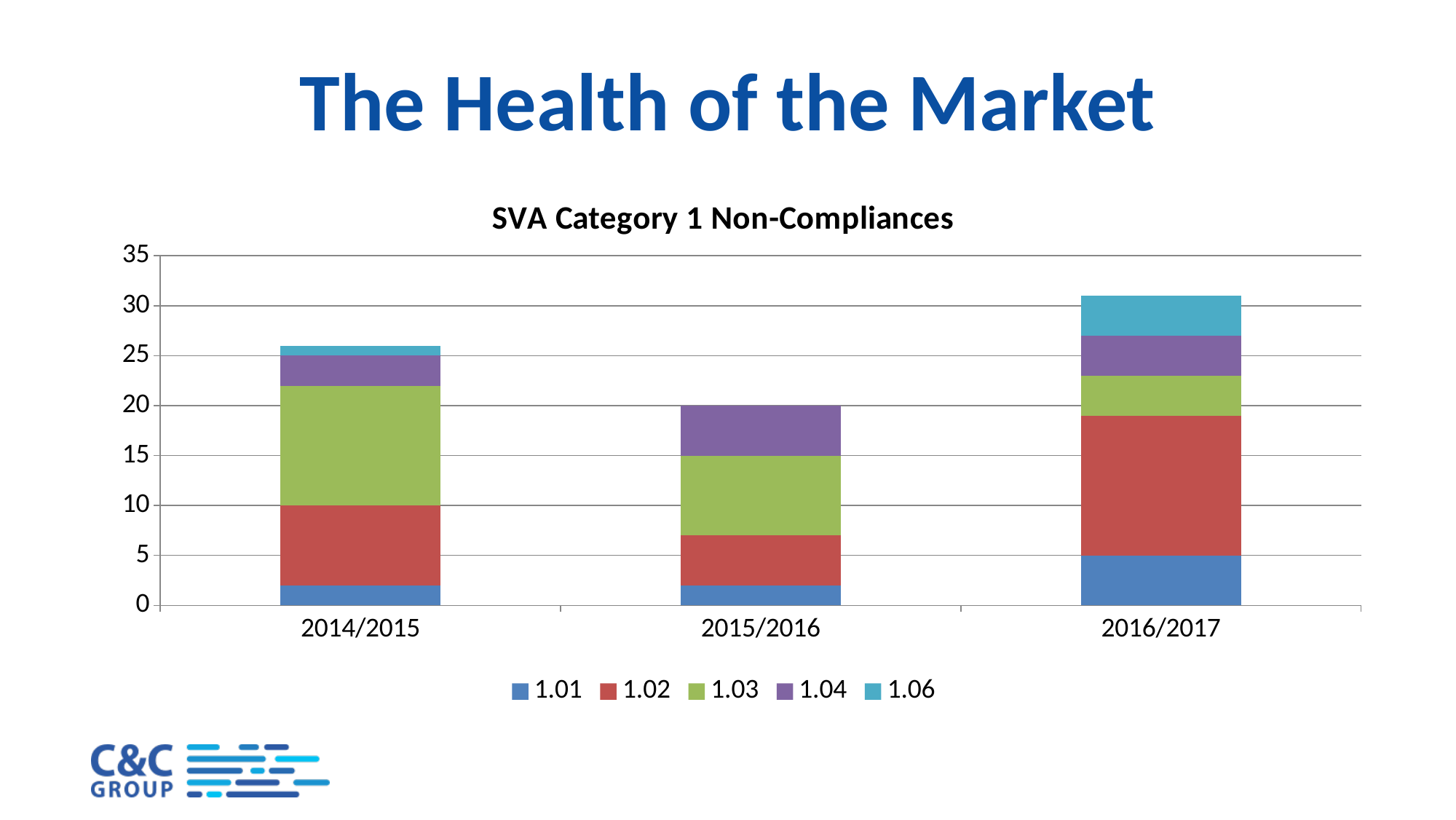
What is the total height of the stacked bar for 2015/2016? 20 Is the total for 2014/2015 greater or less than 30? less How many year categories are shown on the x axis of the chart? 3 What kind of chart is shown on the slide? Stacked bar chart Is the value for series 1.02 in 2016/2017 greater or less than 10? greater Is the total for 2016/2017 greater or less than 25? greater Which is larger, the total for 2014/2015 or the total for 2015/2016? 2014/2015 Which year has the highest total stacked bar? 2016/2017 What is the title of the chart? SVA Category 1 Non-Compliances What is the value for series 1.01 in 2016/2017? 5 Which year has the lowest total stacked bar? 2015/2016 How many series does the legend list? 5